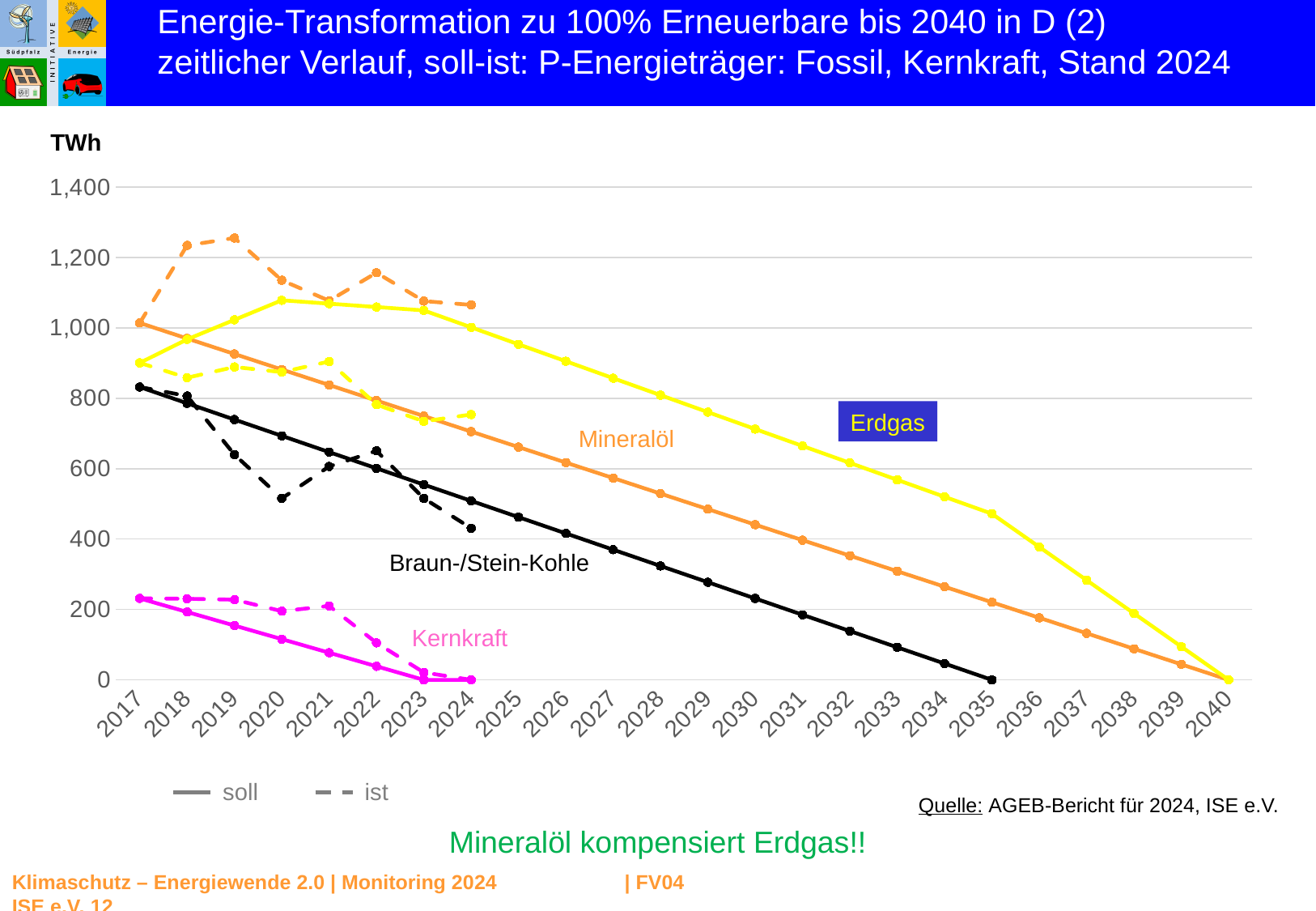
Which energy carrier has the highest soll value in 2030? Erdgas Does the soll line for Mineralöl rise or fall from 2017 to 2040? fall In 2024, which is larger for Mineralöl: the soll value or the ist value? ist Is the ist value for Kernkraft in 2022 greater or less than 200? less What is the soll value for Erdgas in 2040? 0 What type of chart is shown on the slide? line chart How many years are shown on the x axis of the chart? 24 What unit is shown on the y axis of the chart? TWh How many entries does the legend below the chart list? 2 Is the ist value for Erdgas in 2019 greater or less than 1,200? less What is the soll value for Braun-/Stein-Kohle in 2035? 0 Which energy carrier has the lowest soll value in 2017? Kernkraft